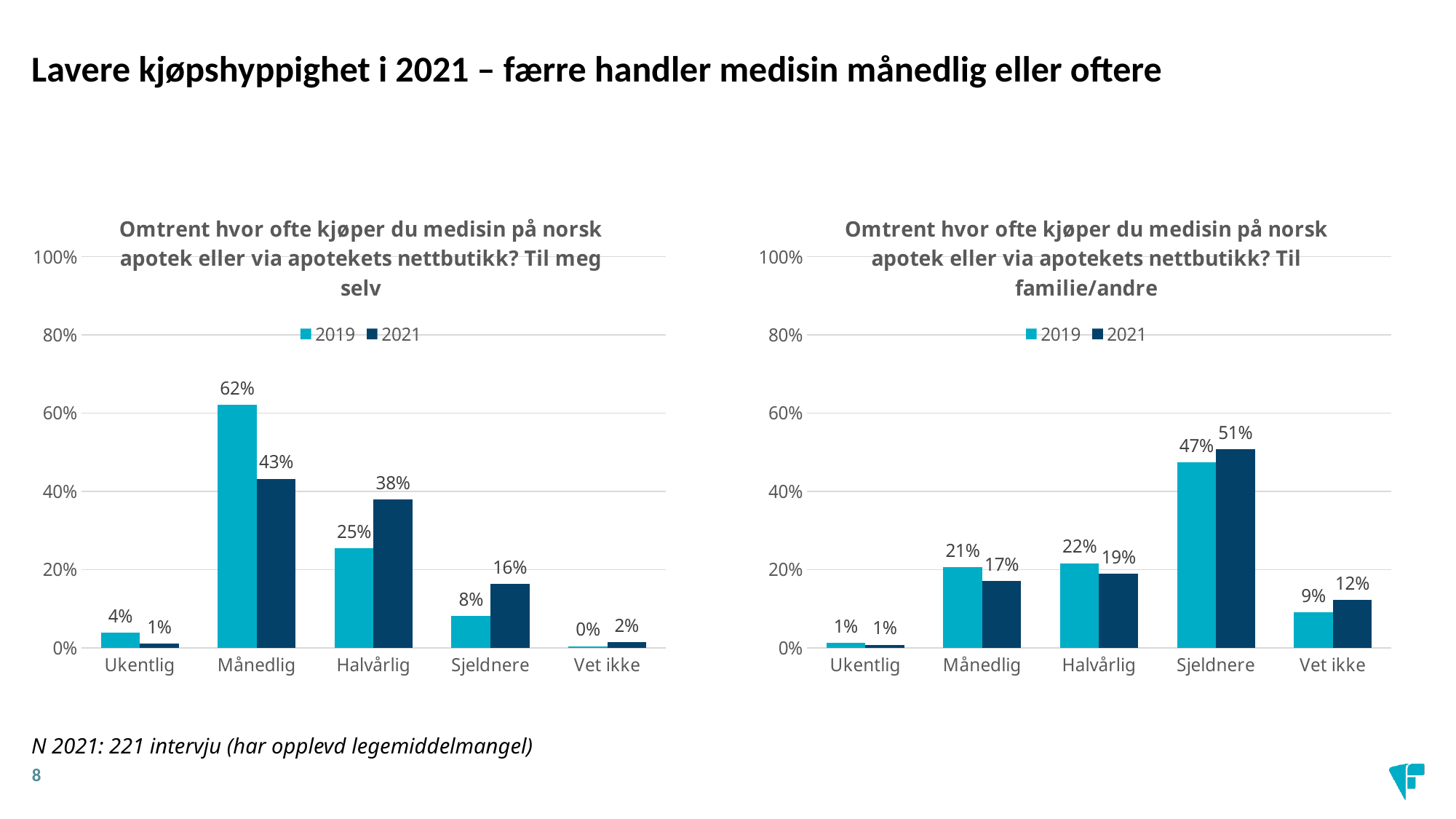
In the left chart ('Til meg selv'), what is the 2019 value for Månedlig? 62% How many series does the legend of the left chart ('Til meg selv') list? 2 In the right chart ('Til familie/andre'), which is larger for Halvårlig: the 2019 value or the 2021 value? 2019 In the right chart ('Til familie/andre'), which category has the lowest 2021 value? Ukentlig In the left chart ('Til meg selv'), what is the 2021 value for Halvårlig? 38% In the right chart ('Til familie/andre'), what is the 2021 value for Sjeldnere? 51% In the left chart ('Til meg selv'), is the 2021 value for Sjeldnere greater or less than 20%? less In the left chart ('Til meg selv'), which category has the highest 2019 value? Månedlig How many categories are shown on the x axis of the right chart ('Til familie/andre')? 5 In the right chart ('Til familie/andre'), what is the 2019 value for Vet ikke? 9% In the left chart ('Til meg selv'), what is the difference between the 2019 and 2021 values for Månedlig? 19 percentage points What kind of chart is the right chart ('Til familie/andre')? Bar chart